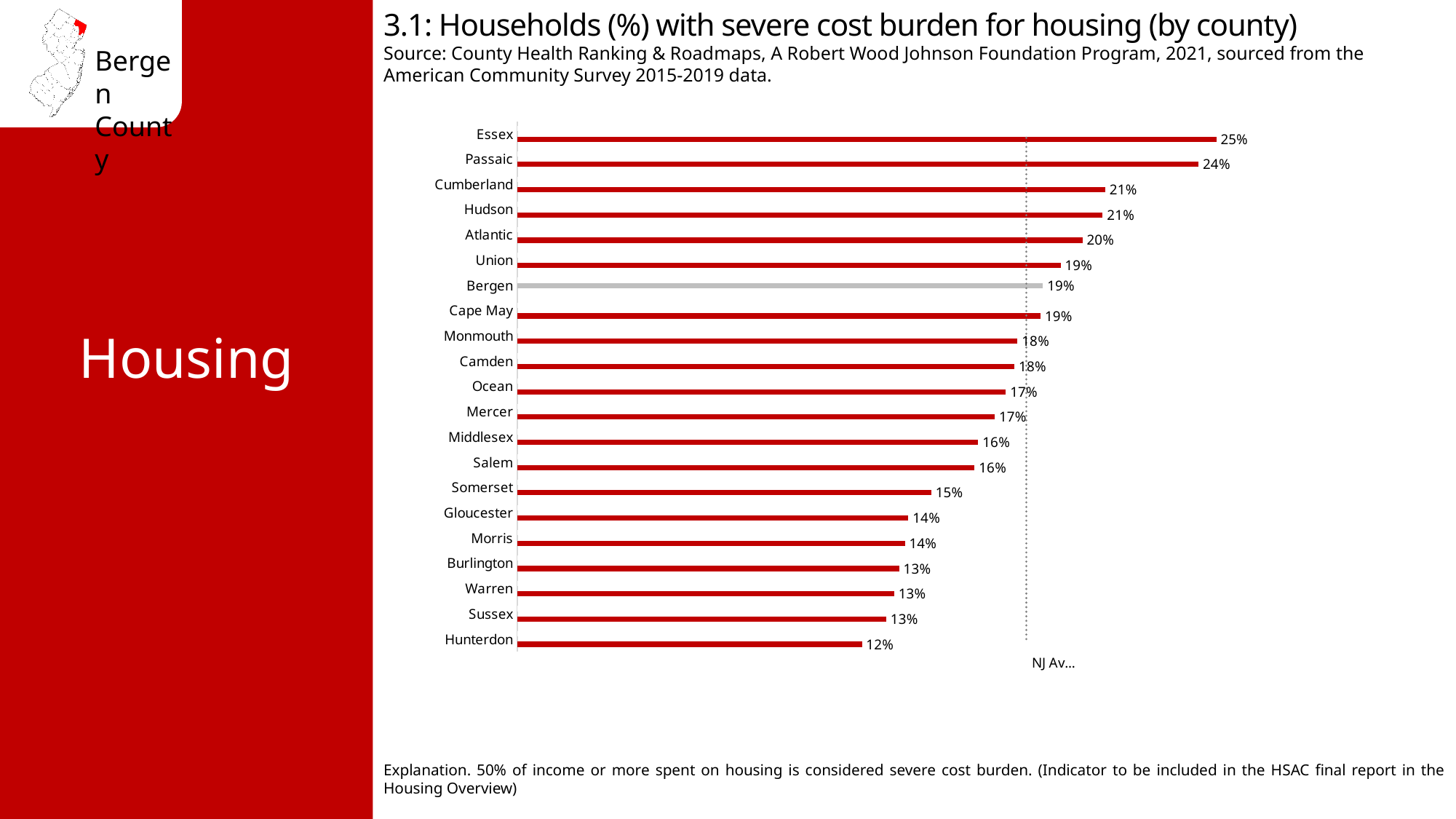
Which county has the highest value? Essex Which county's bar is shown in a different colour (grey) from the others? Bergen What is the value for Essex? 25% What is the value for Somerset? 15% How many counties are shown in the chart? 21 What is the value for Hunterdon? 12% Which is larger, the value for Atlantic or the value for Middlesex? Atlantic What is the difference between the values for Essex and Hunterdon? 13% What is the difference between the values for Passaic and Bergen? 5% Which county has the lowest value? Hunterdon What kind of chart is shown on the slide? Bar chart What is the value for Bergen? 19%